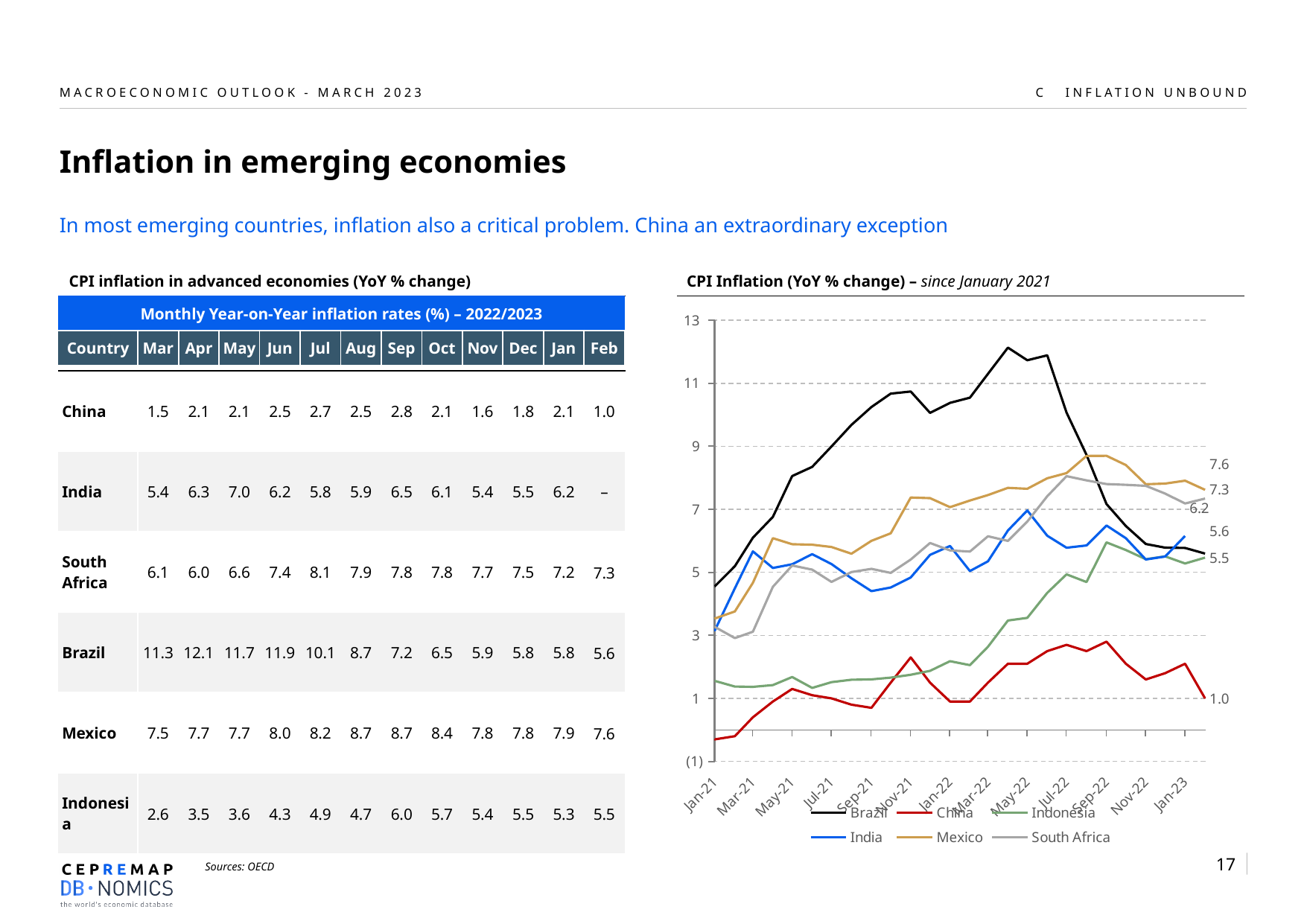
What type of chart is shown on the right side of the slide? line chart How many series does the legend of the CPI Inflation chart list? 6 In the CPI Inflation chart, what is the final labelled value for South Africa? 7.3 In the CPI Inflation chart, which country has the highest value at the end of the series? Mexico In the CPI Inflation chart, which country has the lowest value at the end of the series? China In the CPI Inflation chart, does the Brazil line rise or fall between Jan-21 and May-22? rise In the CPI Inflation chart, is the final value for Mexico or for South Africa larger? Mexico In the CPI Inflation chart, what is the final labelled value for Mexico? 7.6 In the CPI Inflation chart, what is the final labelled value for China? 1.0 In the CPI Inflation chart, which colour is used for the Brazil line? black In the CPI Inflation chart, what is the difference between the final labelled values for Mexico and China? 6.6 In the CPI Inflation chart, is the peak value for Brazil greater or less than 11? greater